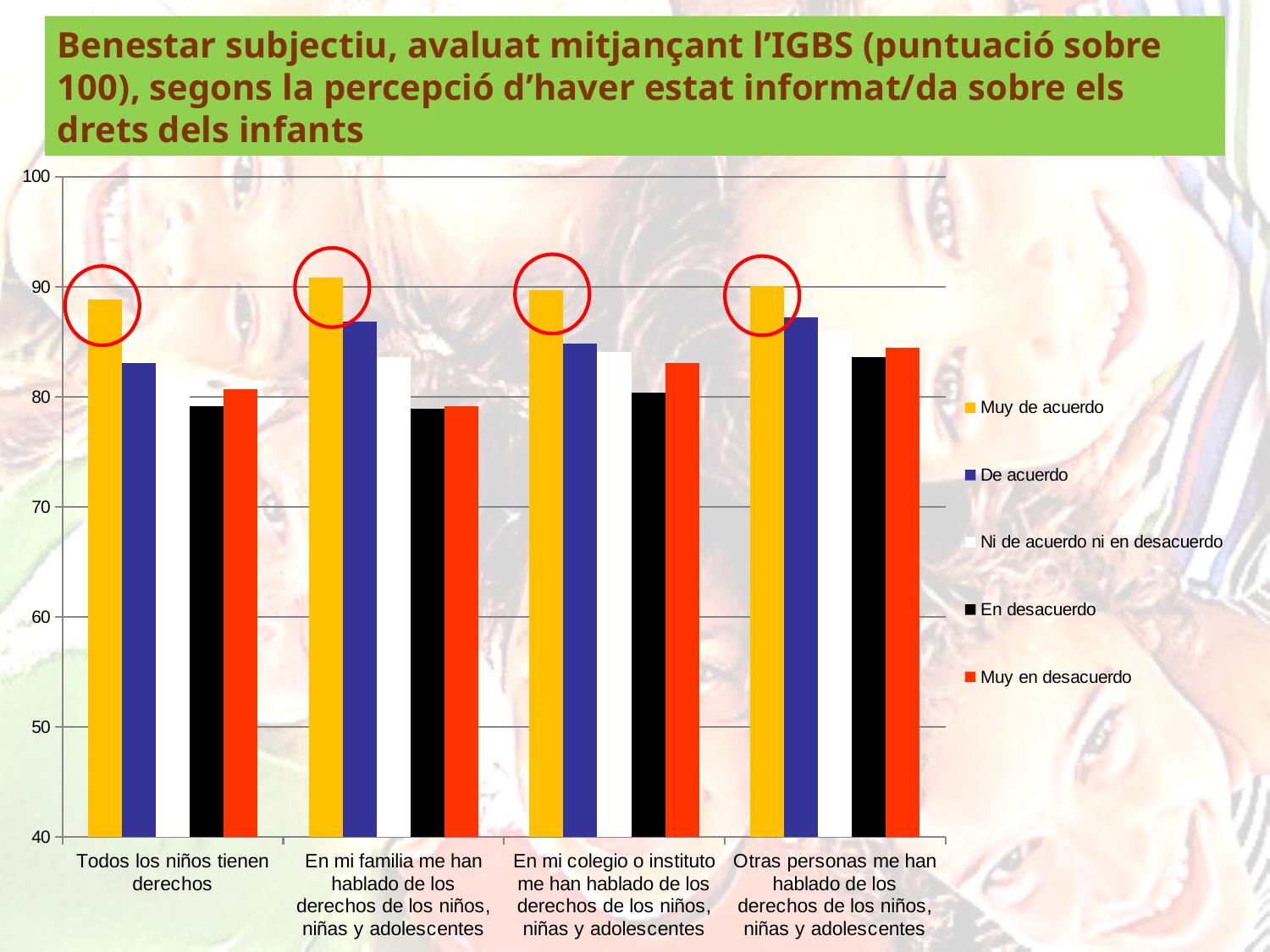
What kind of chart is shown on the slide? bar chart Which series has the highest value in the category 'Todos los niños tienen derechos'? Muy de acuerdo Which series has the lowest value in the category 'En mi colegio o instituto me han hablado de los derechos de los niños, niñas y adolescentes'? En desacuerdo Is the value for 'Muy de acuerdo' in the category 'En mi familia me han hablado de los derechos de los niños, niñas y adolescentes' greater or less than 90? greater Is the value for 'En desacuerdo' in the category 'Otras personas me han hablado de los derechos de los niños, niñas y adolescentes' greater or less than 80? greater Is the value for 'Muy de acuerdo' in the category 'Todos los niños tienen derechos' greater or less than 80? greater Which is larger: the 'Muy de acuerdo' value for 'Todos los niños tienen derechos' or for 'En mi familia me han hablado de los derechos de los niños, niñas y adolescentes'? En mi familia me han hablado de los derechos de los niños, niñas y adolescentes Which series is drawn in yellow? Muy de acuerdo In the category 'Todos los niños tienen derechos', which is larger: 'Muy de acuerdo' or 'De acuerdo'? Muy de acuerdo How many categories are shown along the x axis? 4 How many series does the legend list? 5